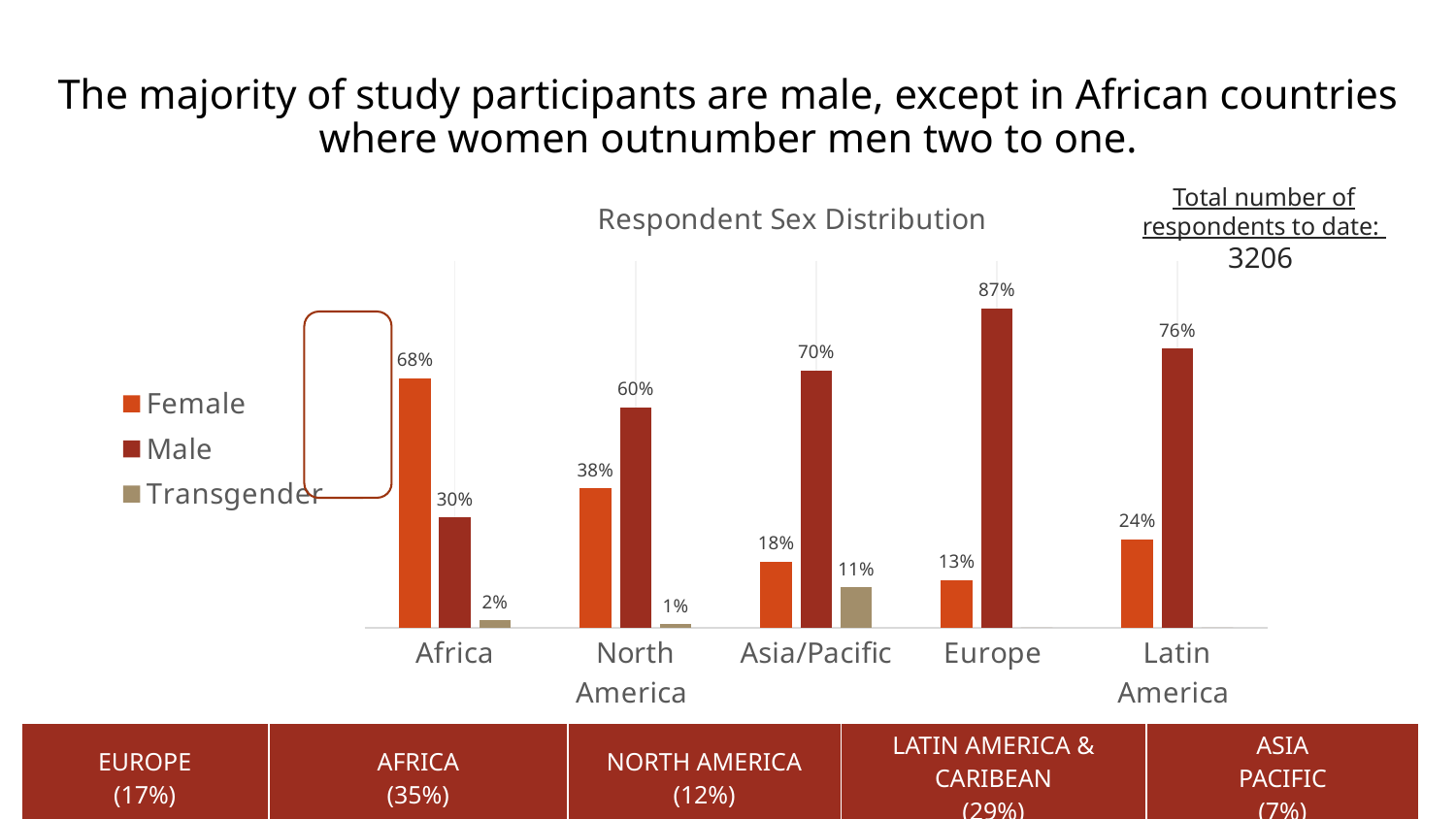
What is the Female value for Latin America in the Respondent Sex Distribution chart? 24% What is the difference between the Male and Female values for North America in the Respondent Sex Distribution chart? 22% How many regions are shown on the x axis of the Respondent Sex Distribution chart? 5 What is the Female value for Africa in the Respondent Sex Distribution chart? 68% What is the Transgender value for Asia/Pacific in the Respondent Sex Distribution chart? 11% What is the title of the chart on the slide? Respondent Sex Distribution In the Respondent Sex Distribution chart, is the Female value for Africa larger or smaller than the Male value for Africa? larger What is the Male value for Europe in the Respondent Sex Distribution chart? 87% How many series does the legend of the Respondent Sex Distribution chart list? 3 Which region has the lowest Female value in the Respondent Sex Distribution chart? Europe What kind of chart is the Respondent Sex Distribution chart? bar chart Which region has the highest Male value in the Respondent Sex Distribution chart? Europe